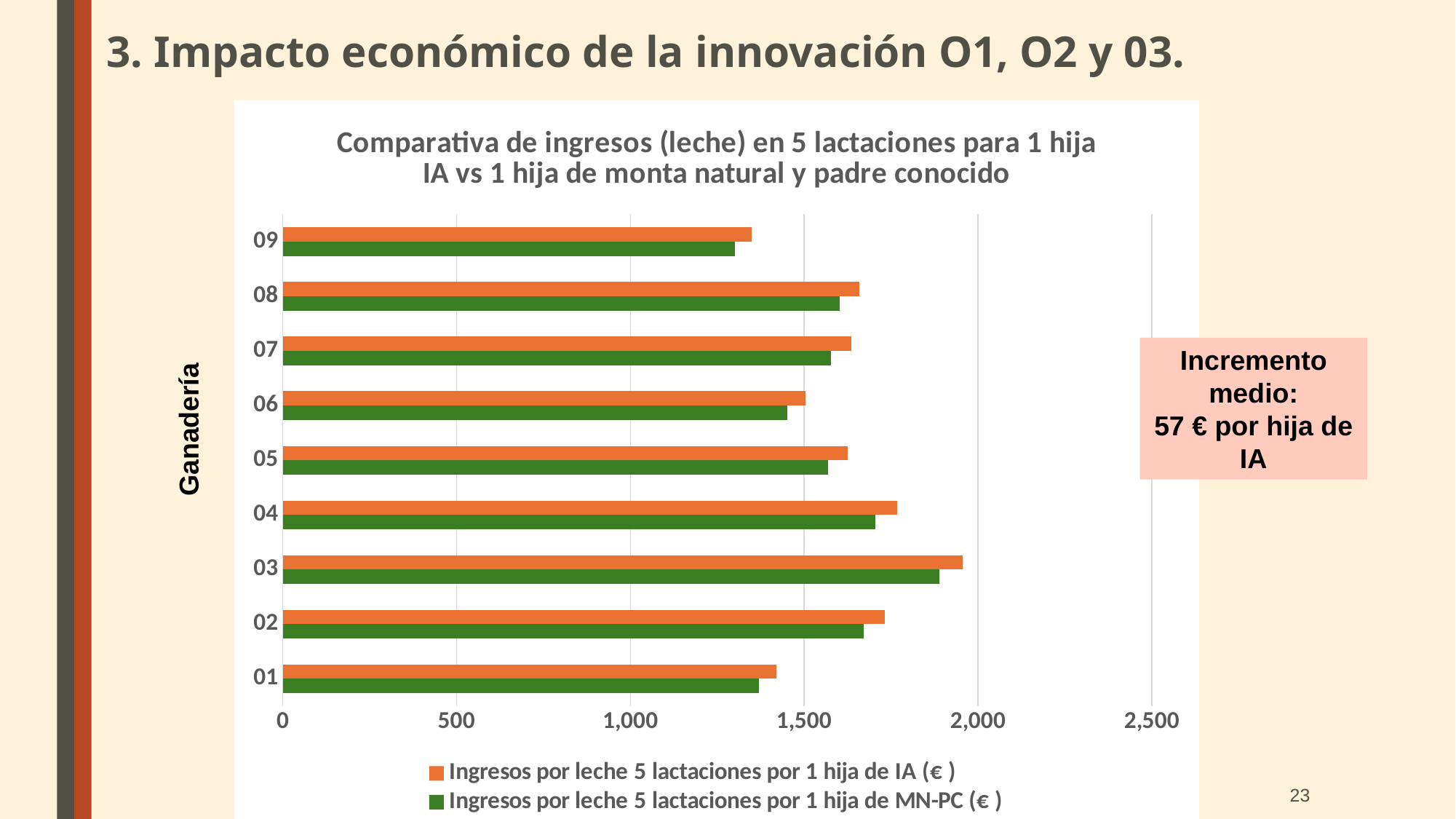
How many ganaderías (categories) are plotted on the chart? 9 How many series does the chart legend list? 2 Is the value for ganadería 01 in the 'hija de MN-PC' series greater or less than 1,500? less Which colour represents the 'Ingresos por leche 5 lactaciones por 1 hija de MN-PC (€)' series? Green Which ganadería has the highest value for 'Ingresos por leche 5 lactaciones por 1 hija de IA (€)'? 03 What kind of chart is shown on the slide? Bar chart Is the value for ganadería 03 in the 'hija de IA' series greater or less than 2,000? less What label is shown on the vertical axis of the chart? Ganadería Which is larger for the 'hija de IA' series: ganadería 03 or ganadería 04? 03 Is the value for ganadería 09 in the 'hija de IA' series greater or less than 1,500? less Which ganadería has the lowest value for 'Ingresos por leche 5 lactaciones por 1 hija de MN-PC (€)'? 09